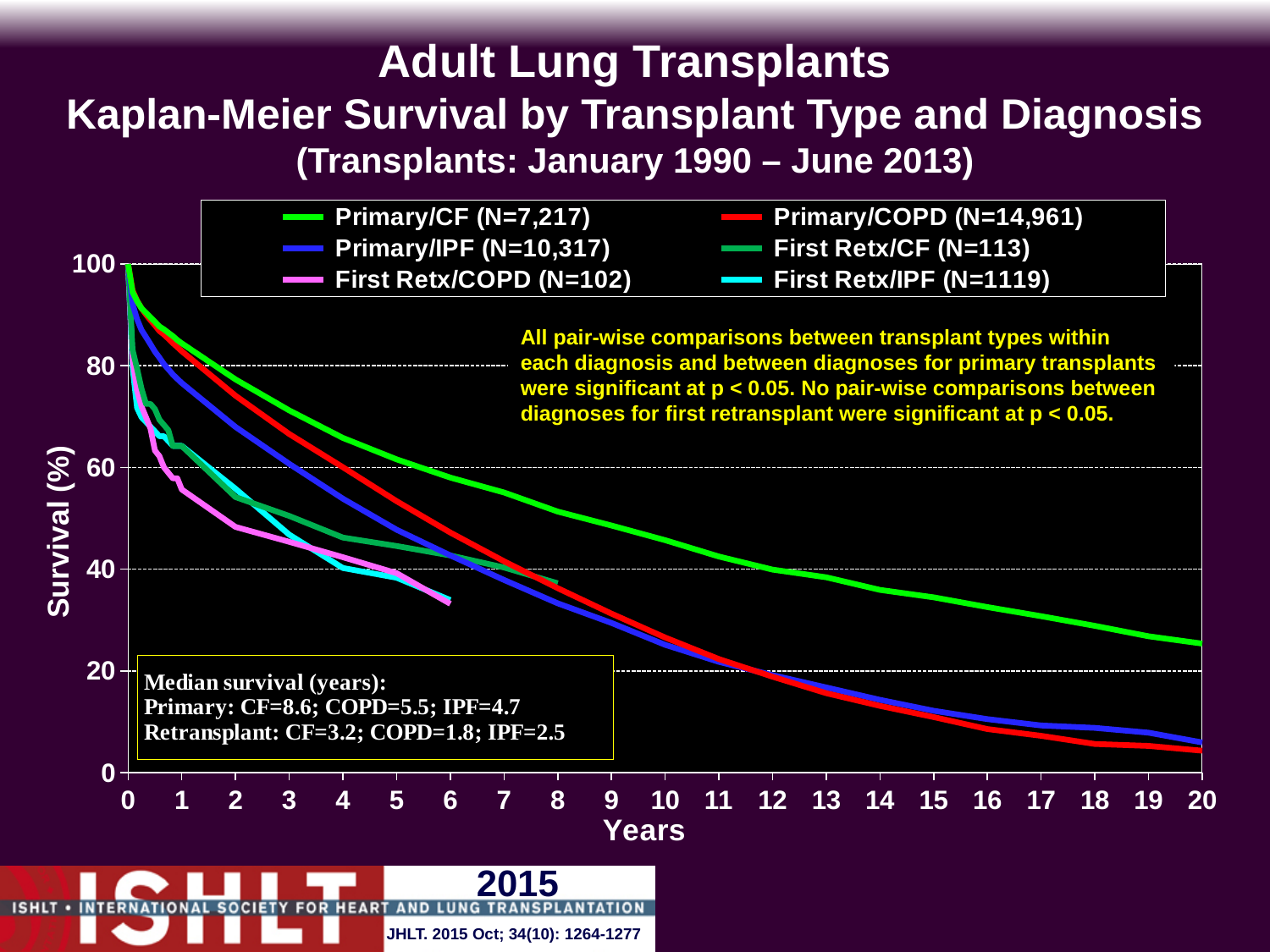
What is the N for the Primary/COPD series in the legend? 14,961 Do the survival curves rise or fall as years increase? fall What is the median survival in years for primary CF transplants? 8.6 What kind of chart is shown on the slide? line chart Which series has the highest survival at 20 years? Primary/CF What is the median survival in years for first retransplant COPD? 1.8 How many series does the legend list? 6 Which has the longer median survival: primary COPD or retransplant COPD? Primary COPD What is the label of the y axis? Survival (%) Is the survival for Primary/COPD at 20 years greater or less than 20%? less What is the difference in median survival (years) between primary CF and primary IPF? 3.9 Is the survival for Primary/CF at 20 years greater or less than 20%? greater